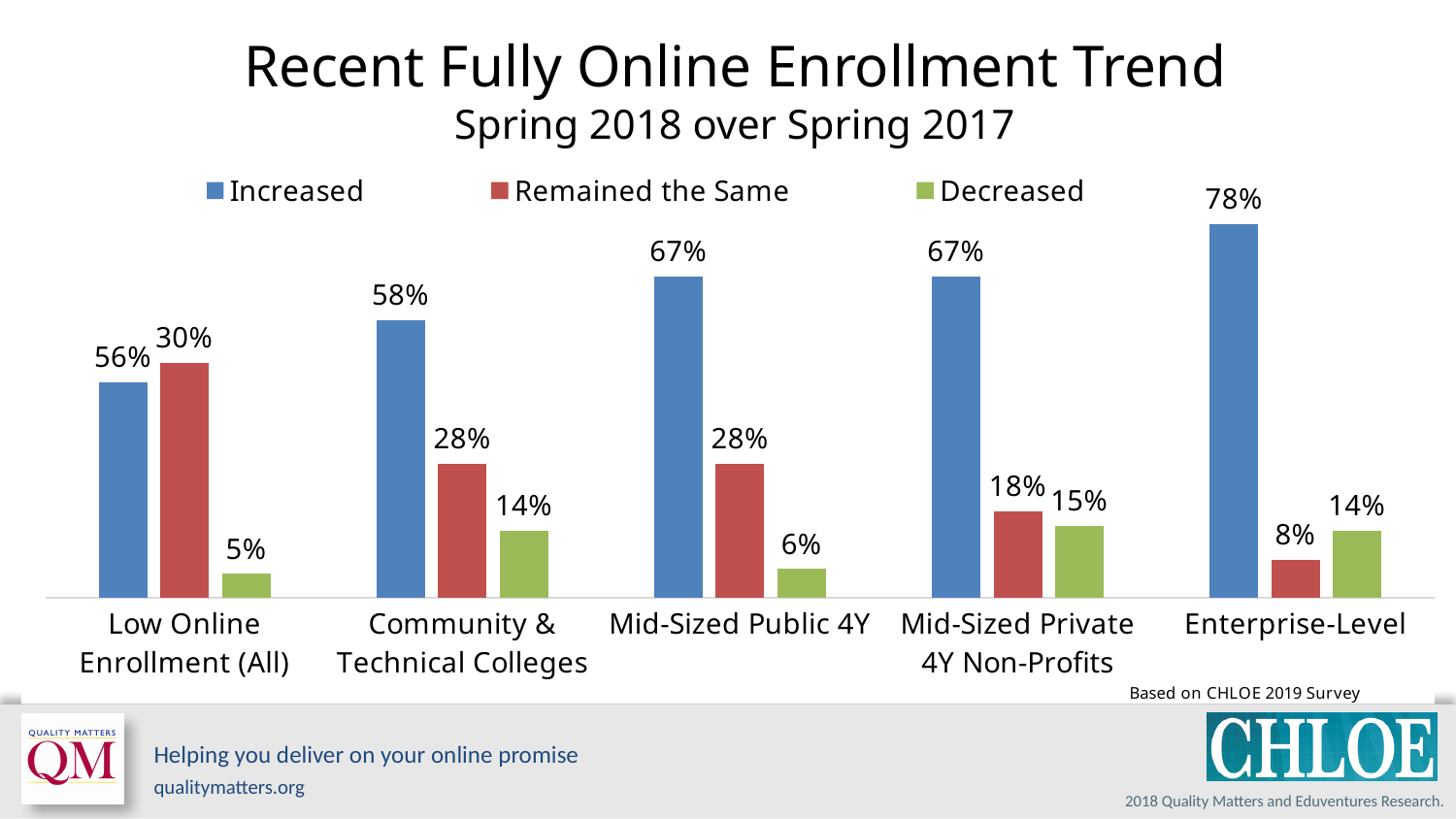
What is the total of the three values for Mid-Sized Private 4Y Non-Profits? 100% Which is larger: the Remained the Same value for Mid-Sized Private 4Y Non-Profits or for Community & Technical Colleges? Community & Technical Colleges What is the difference between the Increased values for Enterprise-Level and Low Online Enrollment (All)? 22% How many categories are shown on the x axis? 5 How many series does the legend list? 3 What is the Decreased value for Mid-Sized Public 4Y? 6% Which category has the lowest Decreased value? Low Online Enrollment (All) Which category has the highest Increased value? Enterprise-Level What kind of chart is shown on the slide? Bar chart What percentage of Enterprise-Level institutions reported that fully online enrollment Increased? 78% What is the subtitle of the chart? Spring 2018 over Spring 2017 What is the Remained the Same value for Low Online Enrollment (All)? 30%